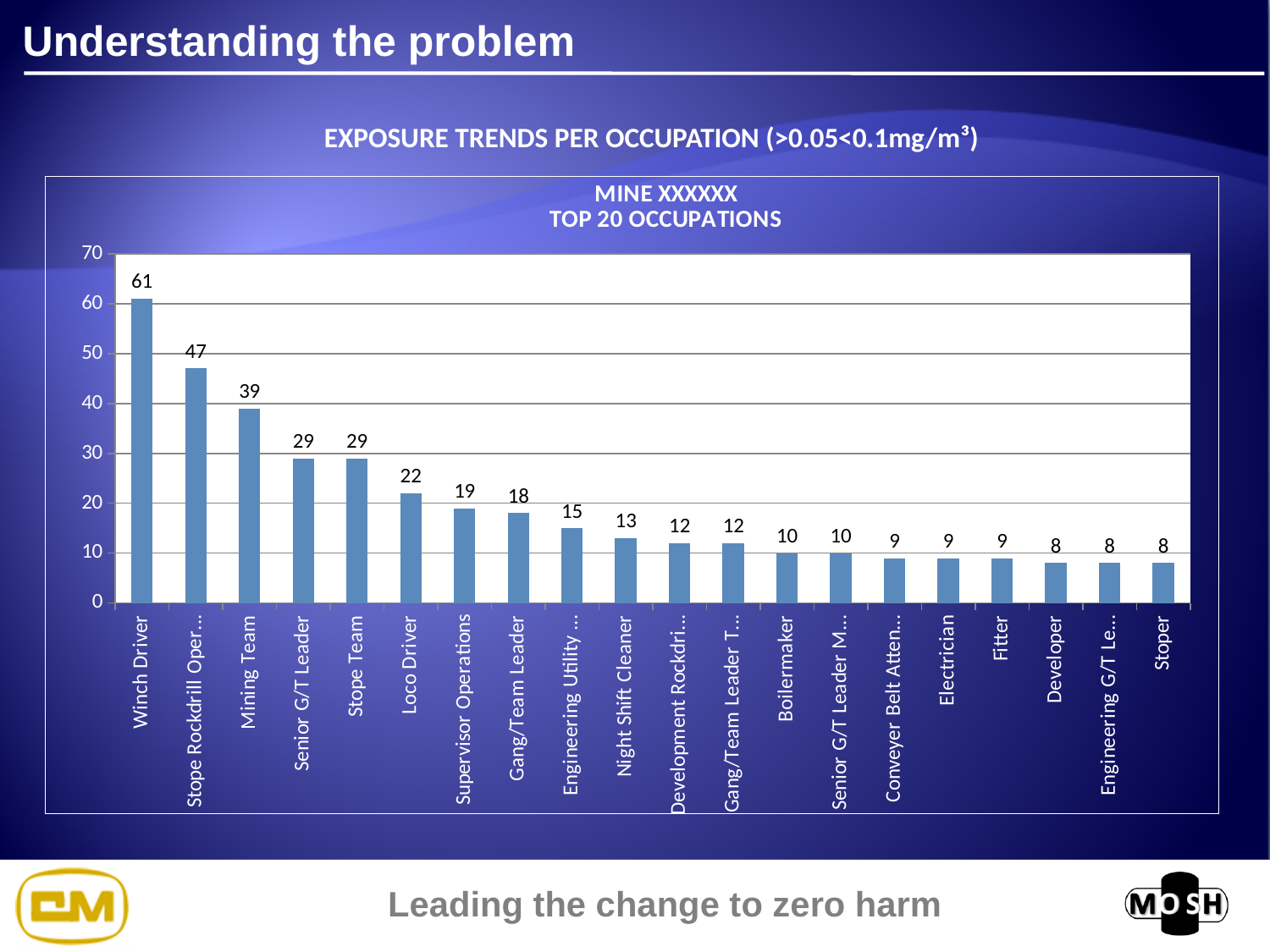
What is the value for Loco Driver? 22 What is the title of the chart? MINE XXXXXX TOP 20 OCCUPATIONS What is the difference between the values for Winch Driver and Mining Team? 22 What kind of chart is shown? Bar chart What is the value for Winch Driver? 61 How many occupations are plotted in the chart? 20 Do the values rise or fall from left to right along the x axis? Fall What is the value for Mining Team? 39 Which occupation has the highest value? Winch Driver Which has a larger value, Night Shift Cleaner or Electrician? Night Shift Cleaner Is the value for Senior G/T Leader greater or less than 20? greater What is the value for Boilermaker? 10